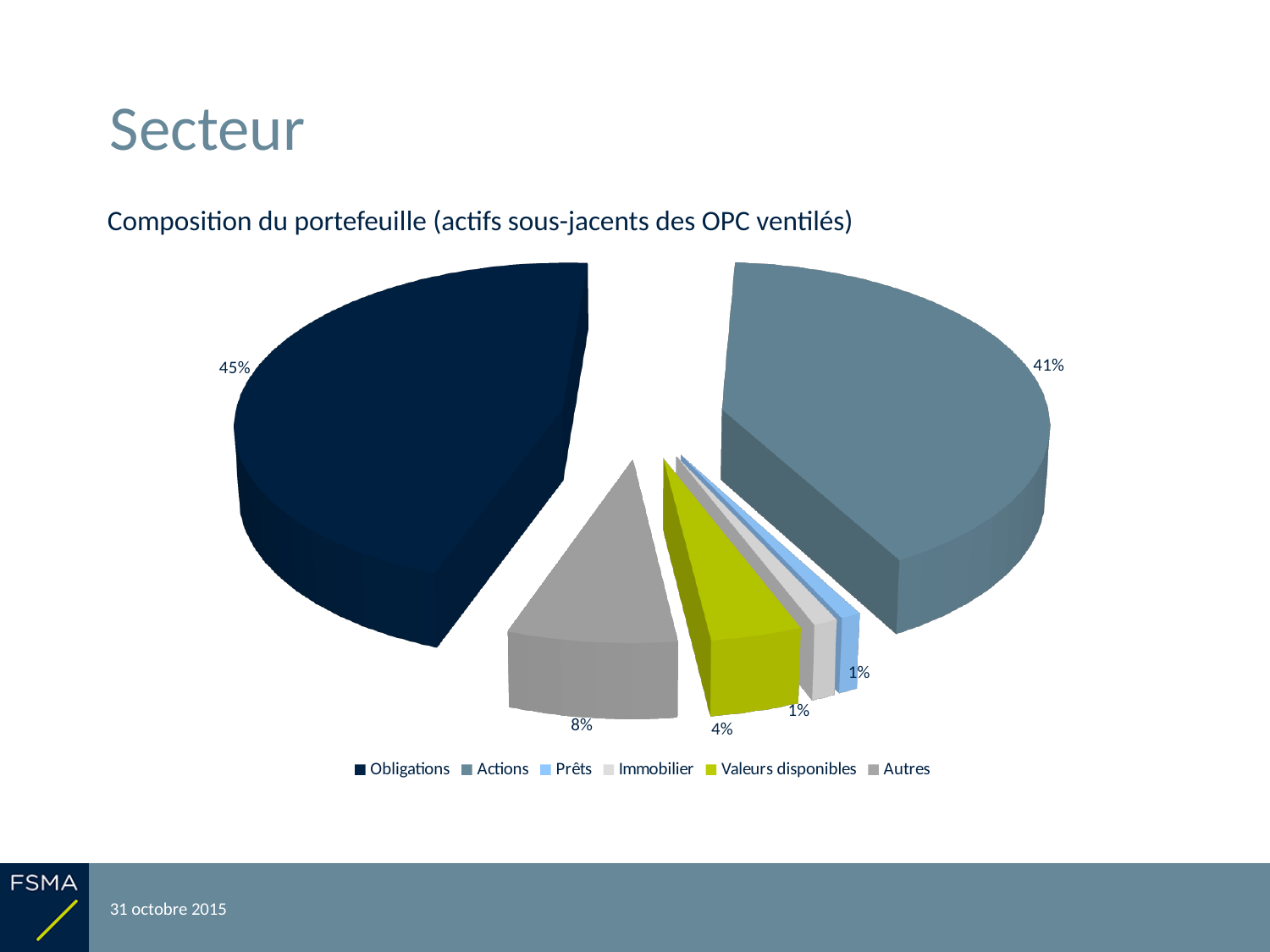
What share of the portfolio is Actions? 41% Which category has the larger share, Autres or Valeurs disponibles? Autres Which legend entry is shown in yellow-green? Valeurs disponibles What share of the portfolio is Immobilier? 1% What share of the portfolio is Obligations? 45% What is the title of the chart? Composition du portefeuille (actifs sous-jacents des OPC ventilés) How many categories does the legend list? 6 What is the difference in percentage points between the Obligations and Actions shares? 4 Which category has the largest share of the pie? Obligations What kind of chart is shown on the slide? pie chart What share of the portfolio is Valeurs disponibles? 4% What share of the portfolio is Autres? 8%